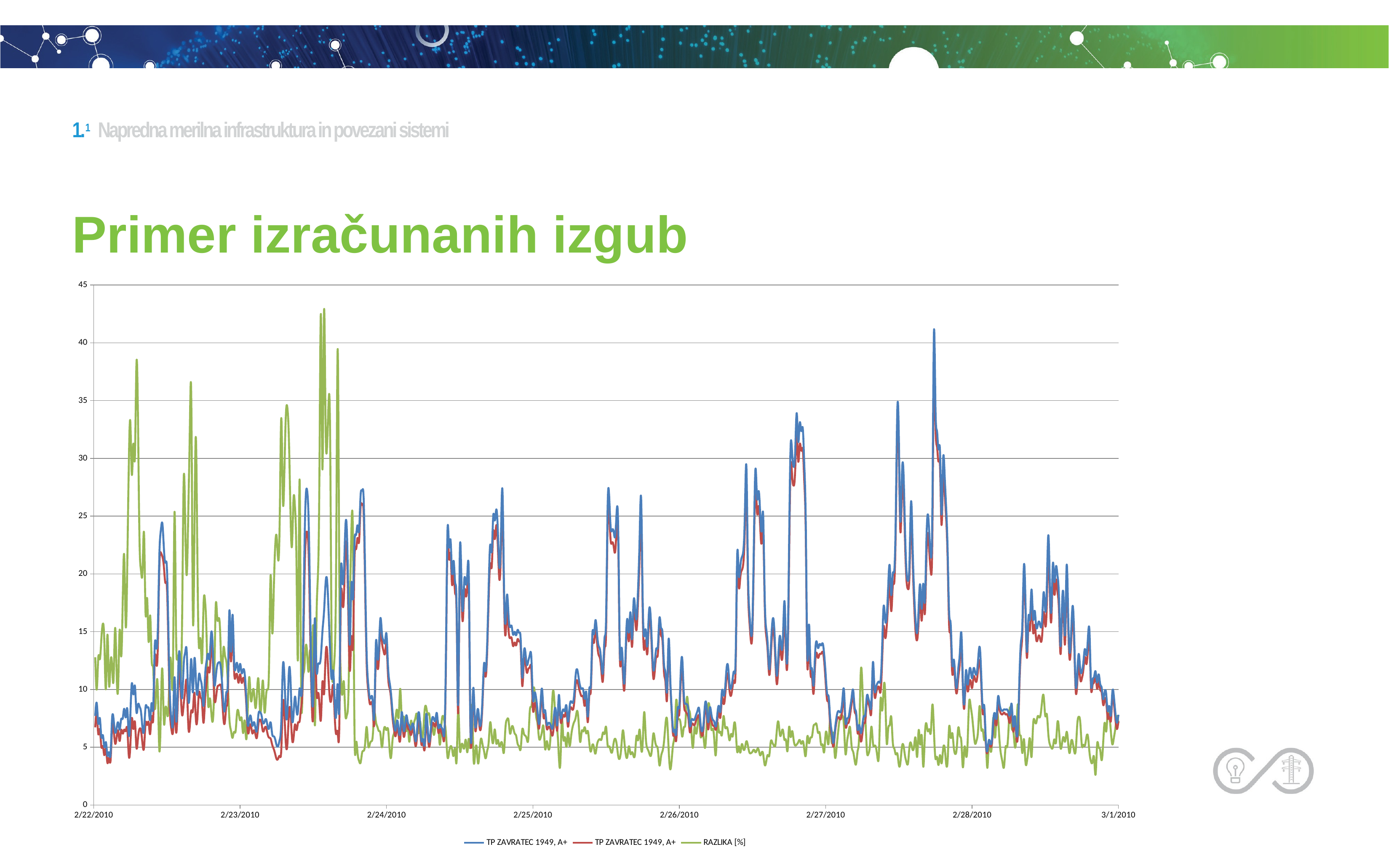
Is the value of the blue line at 2/25/2010 greater or less than 15? less What is the title of the slide above the chart? Primer izračunanih izgub Is the value of the green RAZLIKA [%] line at 3/1/2010 greater or less than 10? less Which legend entry corresponds to the green line? RAZLIKA [%] Is the highest peak of the green RAZLIKA [%] line greater or less than 40? greater How many series does the chart legend list? 3 Between 2/27/2010 and 2/28/2010, which line reaches a higher peak, the blue TP ZAVRATEC 1949, A+ line or the green RAZLIKA [%] line? the blue TP ZAVRATEC 1949, A+ line How many date labels are shown along the x axis? 8 Between 2/22/2010 and 2/23/2010, which series reaches the highest peak? RAZLIKA [%] What kind of chart is shown on the slide? line chart Does the green RAZLIKA [%] line generally rise or fall from 2/22/2010 to 3/1/2010? fall